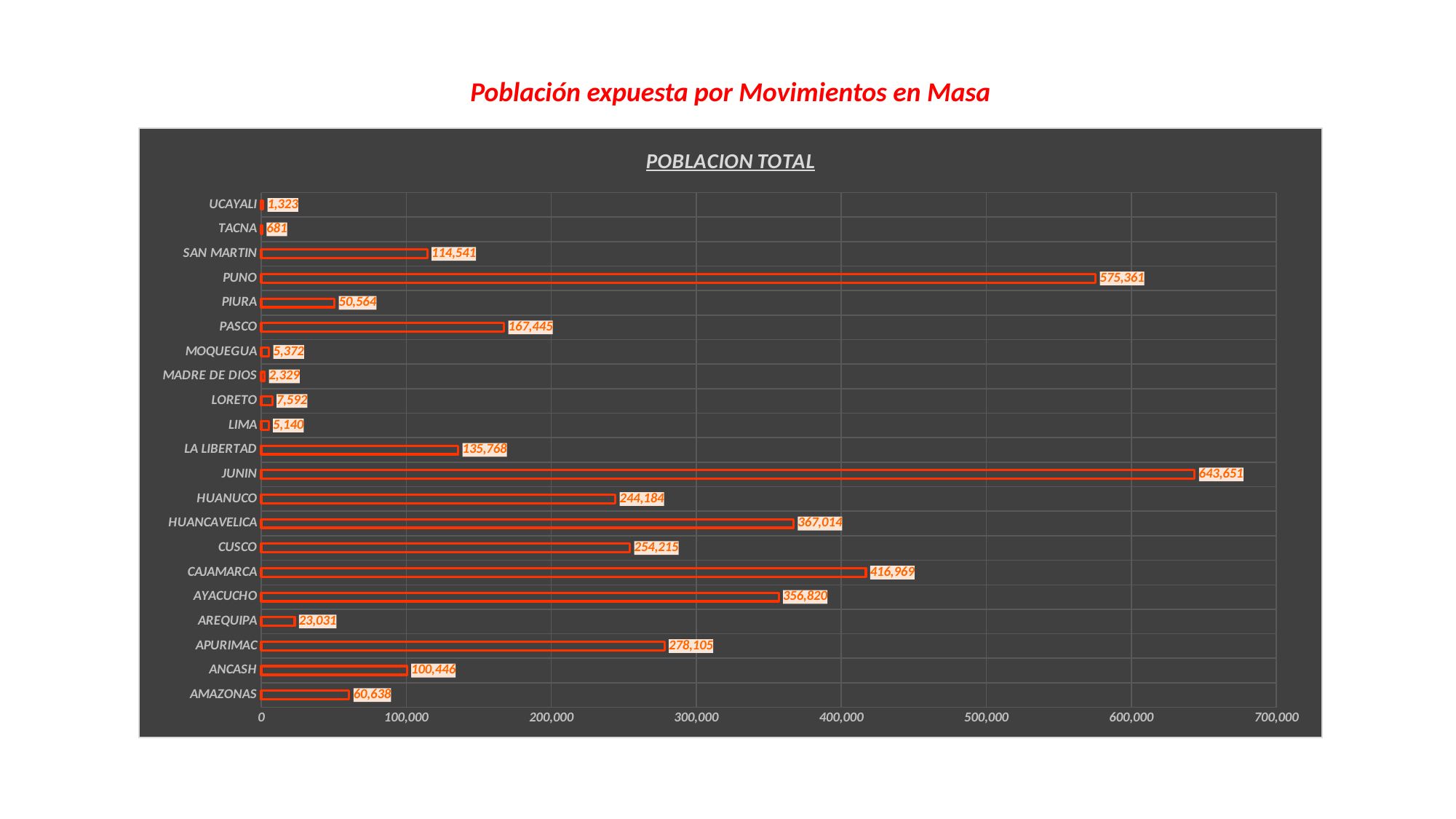
What kind of chart is shown on the slide? bar chart What is the value for HUANCAVELICA? 367,014 What is the difference between the values for CAJAMARCA and HUANCAVELICA? 49,955 What is the difference between the values for JUNIN and PUNO? 68,290 What is the title of the chart inside the dark panel? POBLACION TOTAL What is the value for AMAZONAS? 60,638 Is the value for PASCO greater or less than 100,000? greater Which has a larger value, APURIMAC or CUSCO? APURIMAC Which region has the lowest value in the chart? TACNA Which region has the highest value in the chart? JUNIN How many regions are shown in the chart? 21 What is the value for PUNO in the POBLACION TOTAL chart? 575,361